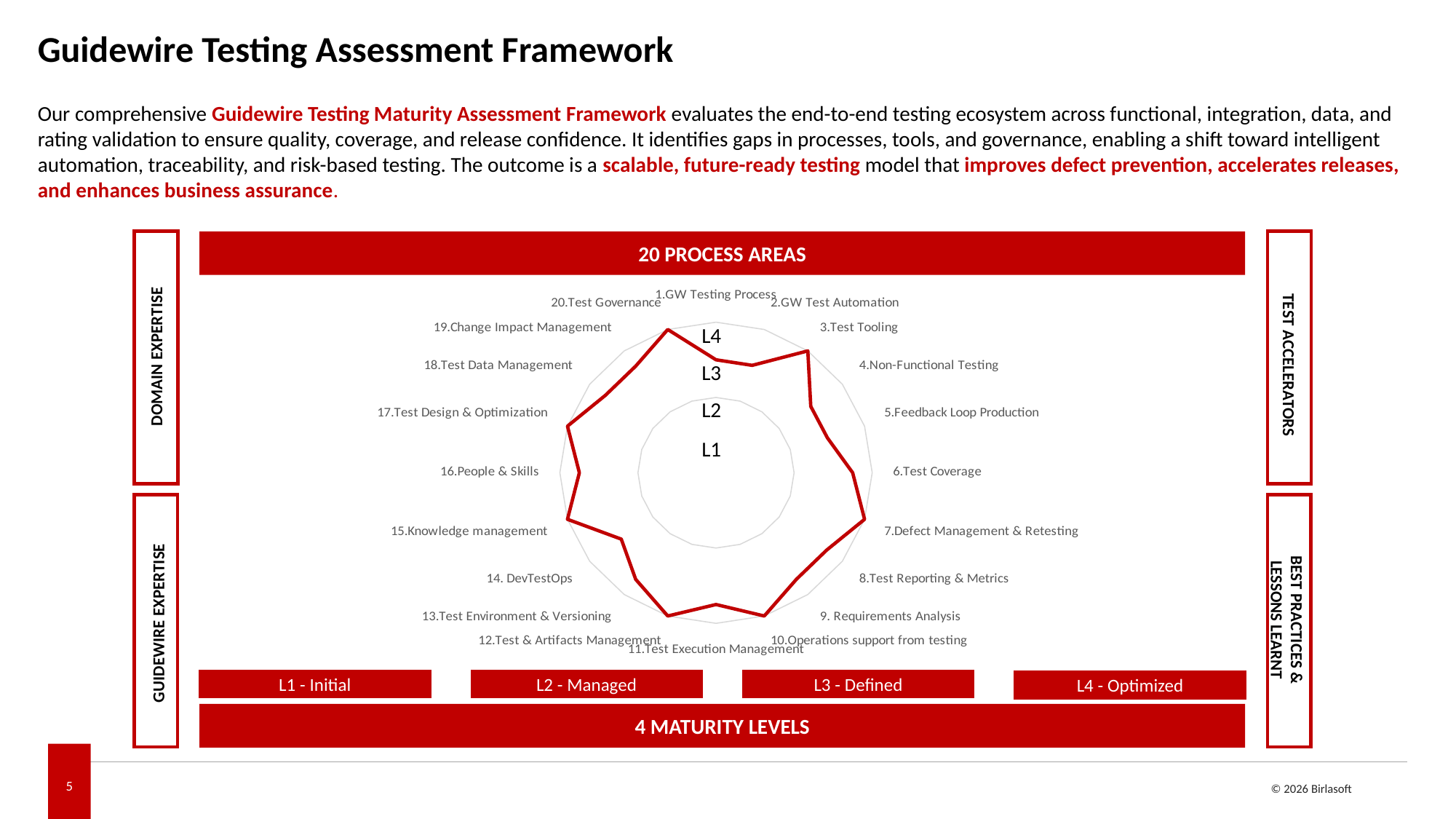
Which is larger on the radar chart: the value for 7.Defect Management & Retesting or the value for 1.GW Testing Process? 7.Defect Management & Retesting Which is larger on the radar chart: the value for 15.Knowledge management or the value for 14. DevTestOps? 15.Knowledge management Which process area is numbered 6 on the radar chart? 6.Test Coverage What kind of chart is shown in the centre of the slide? Radar chart What are the names of the four maturity levels shown below the radar chart? L1 - Initial, L2 - Managed, L3 - Defined, L4 - Optimized Which is larger on the radar chart: the value for 19.Change Impact Management or the value for 1.GW Testing Process? 19.Change Impact Management How many process areas (categories) are plotted on the radar chart? 20 How many maturity levels are marked on the radar chart's rings? 4 What is the title shown in the red banner above the radar chart? 20 PROCESS AREAS